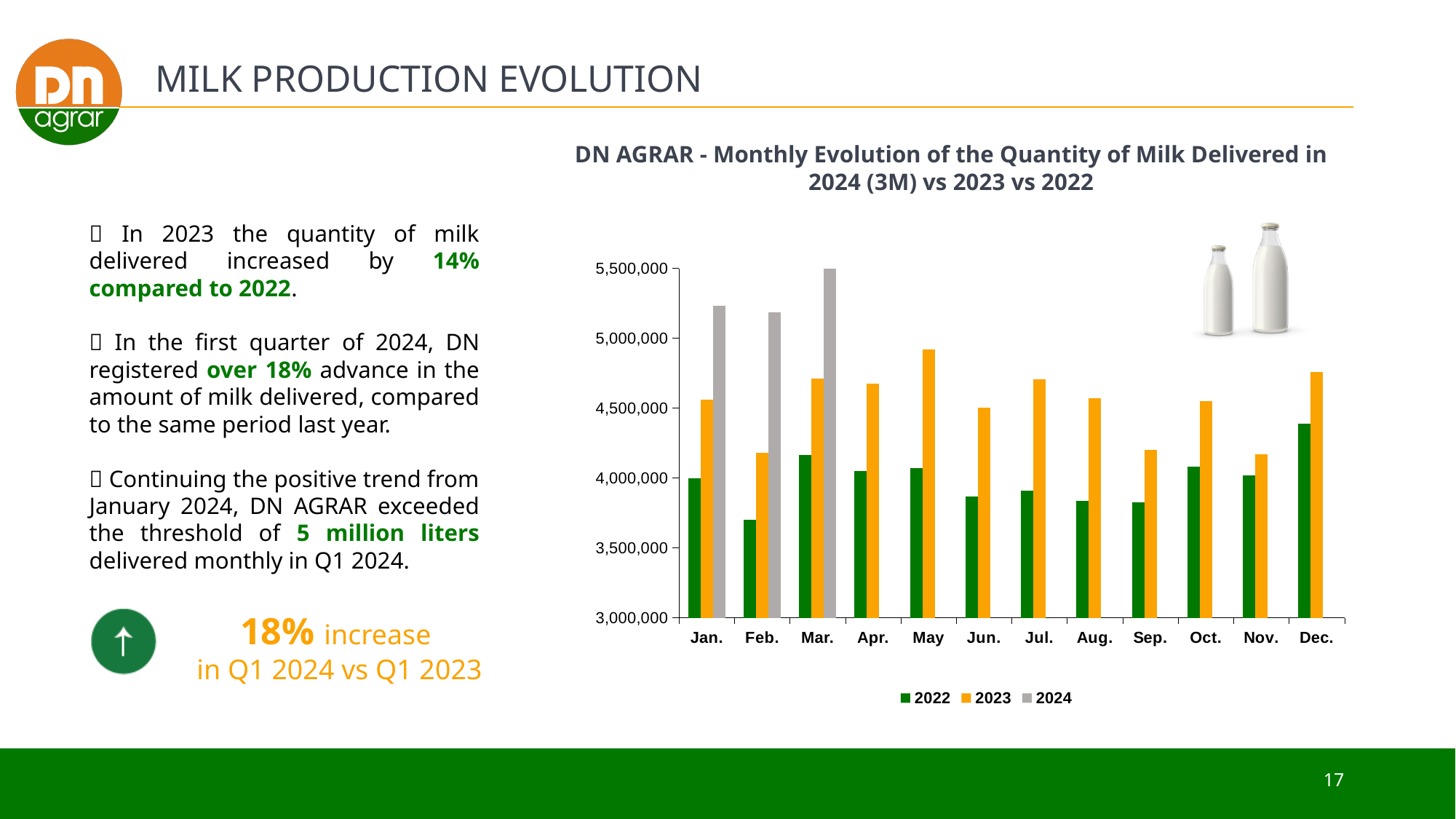
How many months are shown on the x axis? 12 Is the 2023 value for Dec. greater or less than 4,500,000? greater How many series does the legend list? 3 Is the 2024 value for Mar. greater or less than 5,000,000? greater Is the 2022 value for Feb. greater or less than 4,000,000? less In which month is the 2022 value lowest? Feb. In which month is the 2023 value highest? May What kind of chart is shown on the slide? Bar chart Which colour represents the 2024 series in the legend? Grey In which month is the 2024 value highest? Mar. For how many months is a 2024 bar plotted? 3 Which is larger in Jan., the 2024 value or the 2023 value? 2024